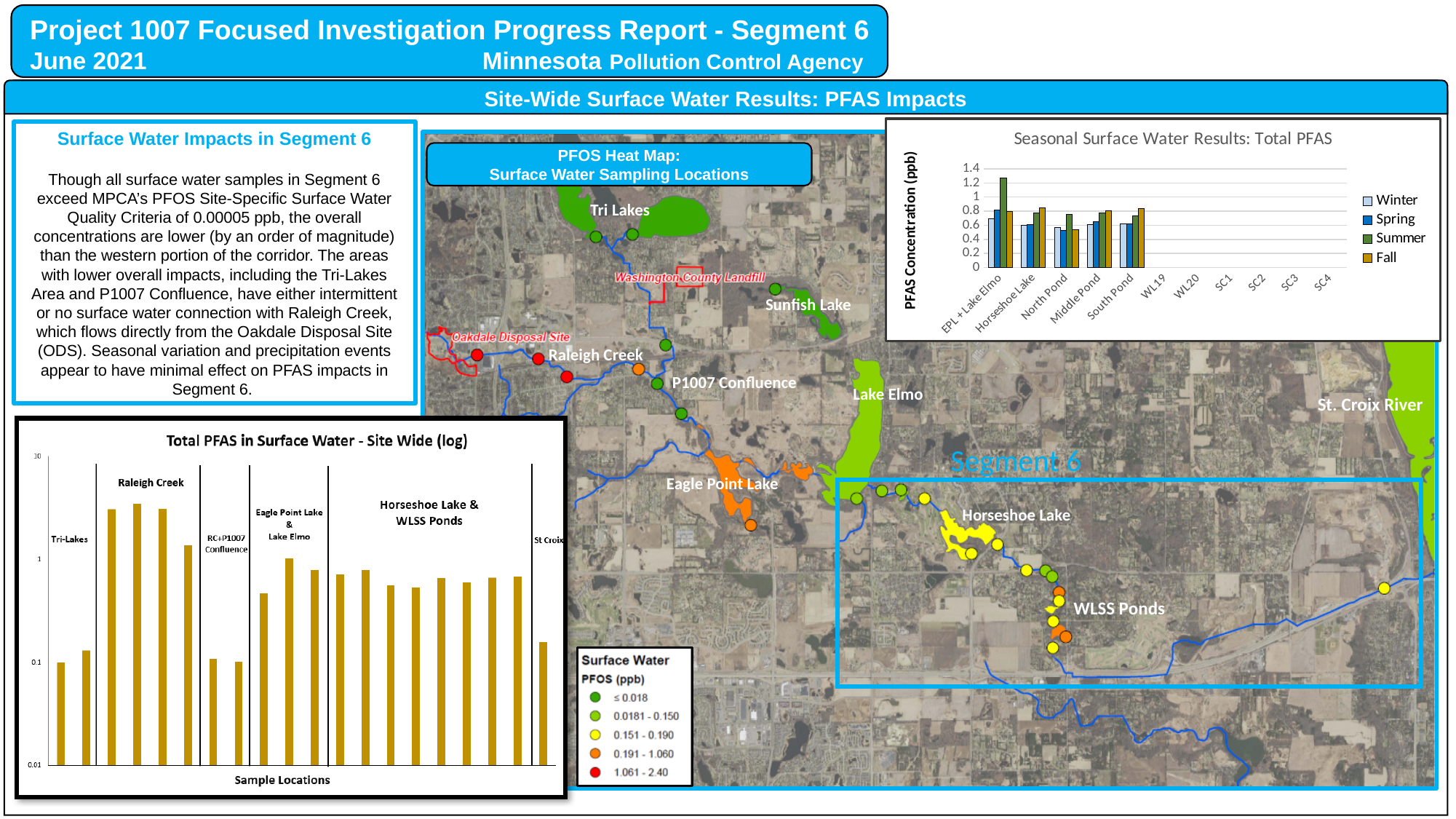
In the 'Seasonal Surface Water Results: Total PFAS' chart, is the Summer value for North Pond greater or less than 0.6? greater In the 'Seasonal Surface Water Results: Total PFAS' chart, how many series does the legend list? 4 In the 'Total PFAS in Surface Water - Site Wide (log)' chart, which labelled location group has the tallest bars? Raleigh Creek In the 'Seasonal Surface Water Results: Total PFAS' chart, what is the y-axis label? PFAS Concentration (ppb) What kind of chart is 'Total PFAS in Surface Water - Site Wide (log)'? bar chart In the 'Seasonal Surface Water Results: Total PFAS' chart, what are the legend entries? Winter, Spring, Summer, Fall In the 'Seasonal Surface Water Results: Total PFAS' chart, is the Winter value for EPL + Lake Elmo greater or less than 0.8? less In the 'Seasonal Surface Water Results: Total PFAS' chart, which season has the highest bar for EPL + Lake Elmo? Summer In the 'Seasonal Surface Water Results: Total PFAS' chart, how many categories are labelled on the x axis? 11 In the 'Total PFAS in Surface Water - Site Wide (log)' chart, how many location groups are labelled? 6 In the 'Total PFAS in Surface Water - Site Wide (log)' chart, are the Tri-Lakes bars greater or less than 1? less